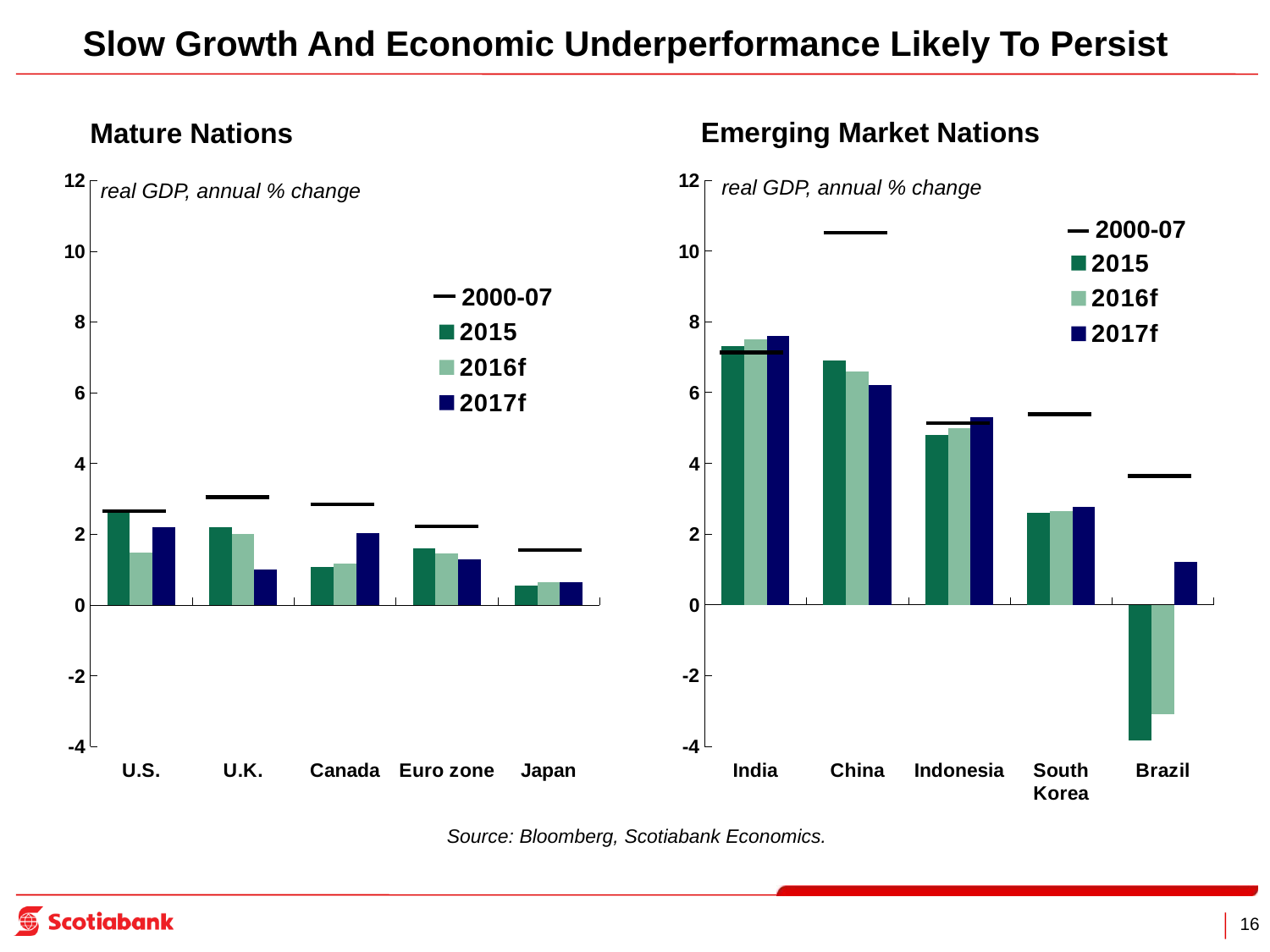
In the Emerging Market Nations chart, which country has the lowest 2015 value? Brazil In the Mature Nations chart, how many countries are shown on the x axis? 5 What does the italic label inside each chart say the values represent? real GDP, annual % change In the Emerging Market Nations chart, how many series does the legend list? 4 In the Mature Nations chart, is the 2015 value for Japan greater or less than 2? less In the Emerging Market Nations chart, is the 2017f value for India greater or less than 6? greater In the Emerging Market Nations chart, is the 2000-07 value for China greater or less than 10? greater What kind of chart is the Mature Nations chart? bar chart In the Mature Nations chart, which country has the lowest 2015 value? Japan In the Mature Nations chart, which is larger for the U.S.: the 2015 value or the 2016f value? 2015 In the Emerging Market Nations chart, which is larger for Brazil: the 2016f value or the 2017f value? 2017f